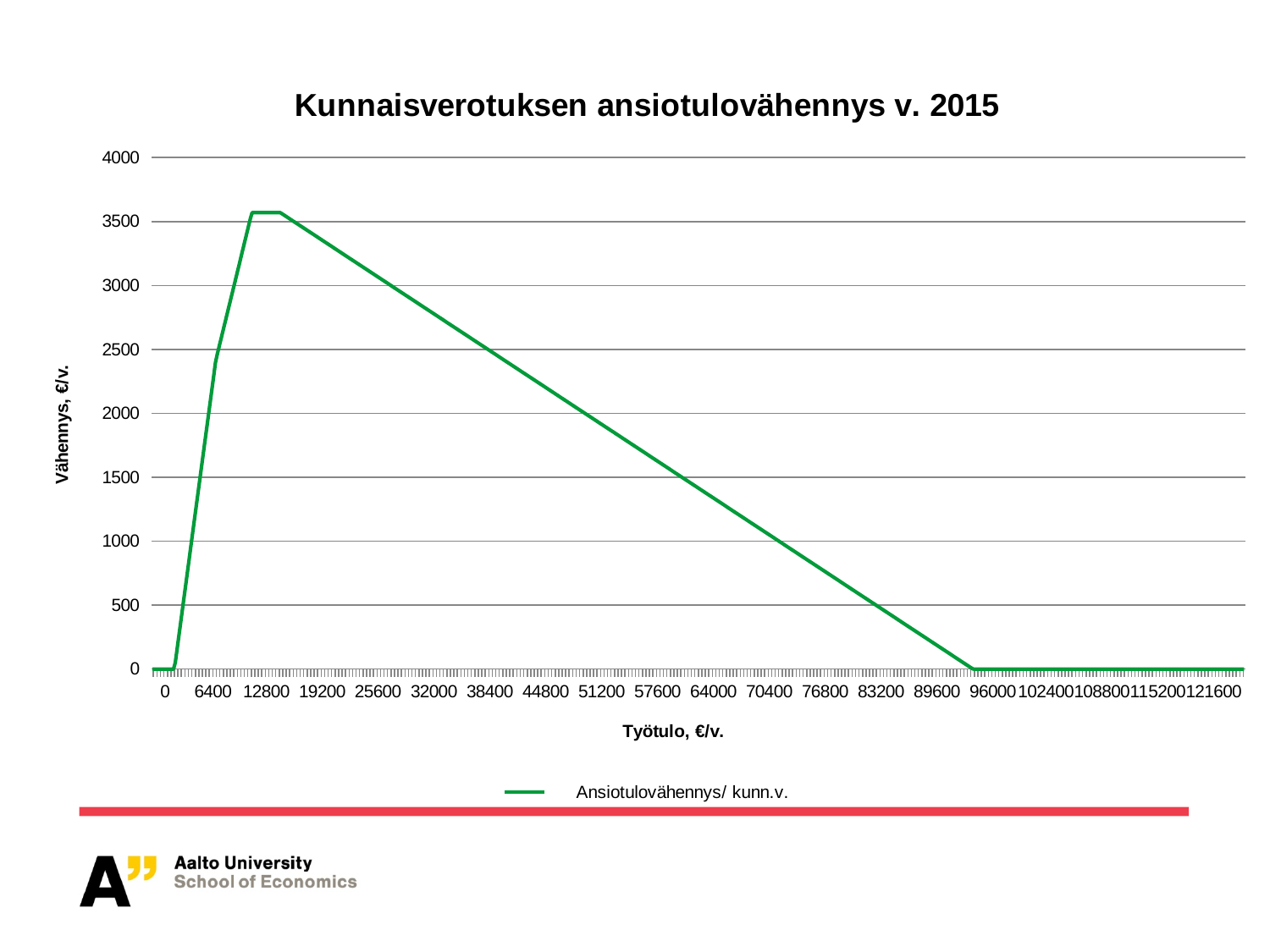
What is the title of the chart? Kunnaisverotuksen ansiotulovähennys v. 2015 What is the value of the line at a Työtulo of 121600? 0 Which is larger: the value at a Työtulo of 25600 or at 70400? 25600 Is the value at a Työtulo of 32000 greater or less than 2500? greater What is the value of the line at a Työtulo of 0? 0 Between a Työtulo of 19200 and 89600, does the line rise or fall? fall Is the value at a Työtulo of 76800 greater or less than 1000? less Is the value at a Työtulo of 89600 greater or less than 500? less How many series does the legend list? 1 What is the legend entry for the plotted line? Ansiotulovähennys/ kunn.v. What kind of chart is shown on the slide? line chart